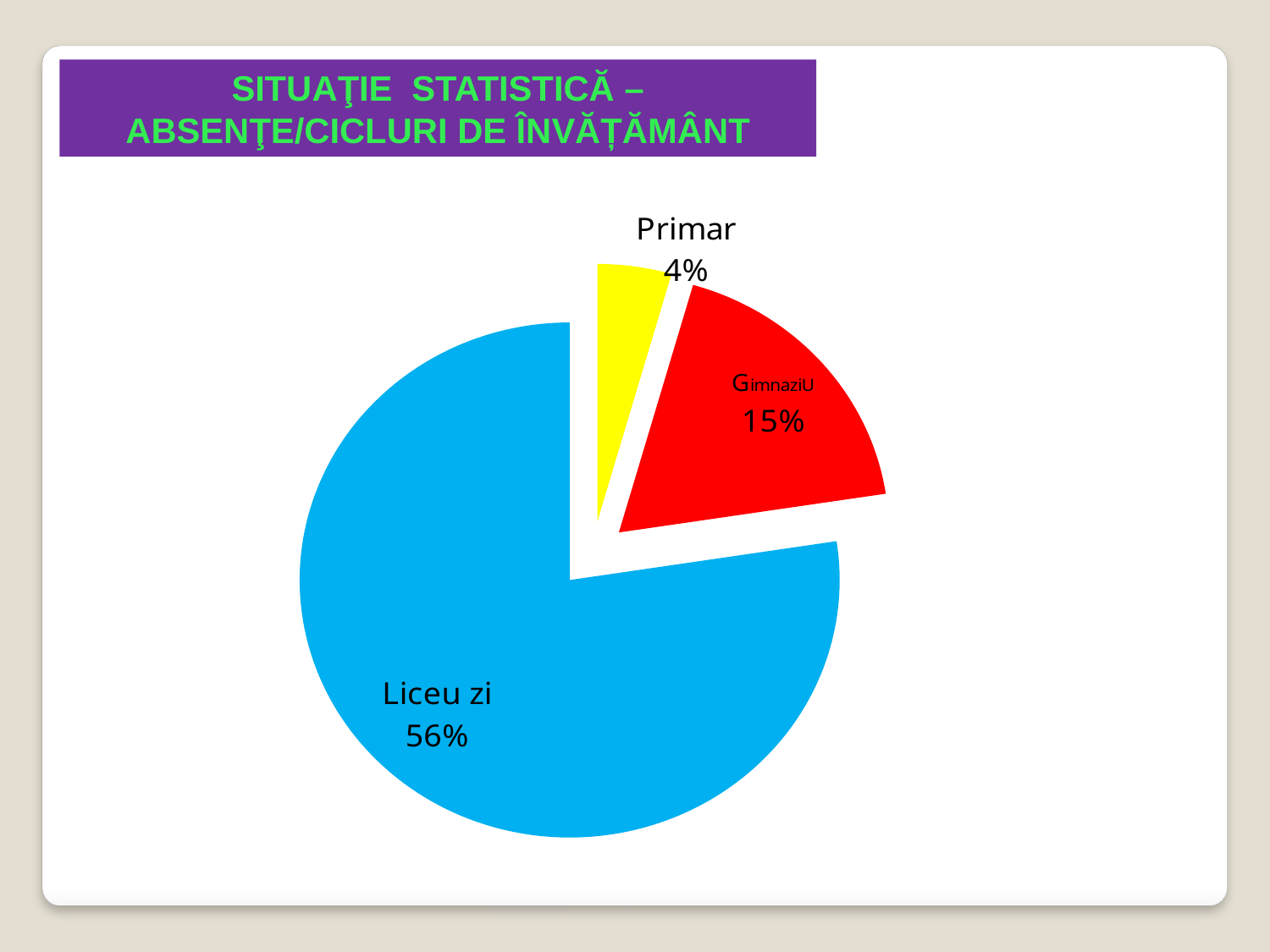
What is the difference in percentage points between the Gimnaziu slice and the Primar slice? 11 What colour is the Liceu zi slice? blue Which is larger, the Gimnaziu slice or the Primar slice? Gimnaziu What is the difference in percentage points between the Liceu zi slice and the Gimnaziu slice? 41 What percentage is shown for the Liceu zi slice? 56% Which category has the smallest slice of the pie? Primar What percentage is shown for the Gimnaziu slice? 15% What kind of chart is shown on the slide? pie chart How many slices does the pie chart have? 3 What percentage is shown for the Primar slice? 4% What colour is the Primar slice? yellow Which category has the largest slice of the pie? Liceu zi